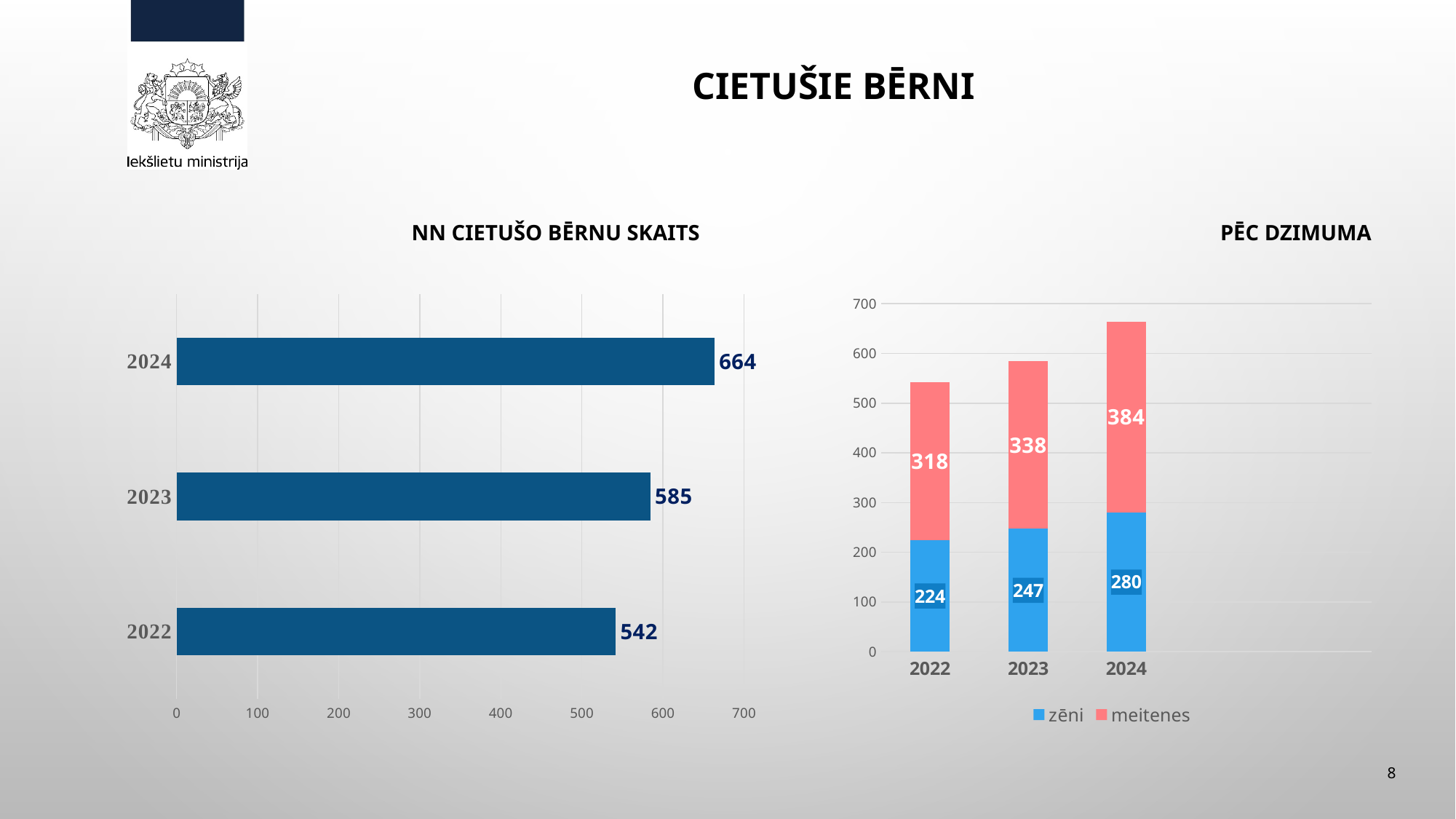
In the 'PĒC DZIMUMA' chart, what is the value for meitenes in 2023? 338 In the 'PĒC DZIMUMA' chart, what is the total of the stacked bar for 2022? 542 In the 'NN CIETUŠO BĒRNU SKAITS' chart, what is the value for 2022? 542 In the 'PĒC DZIMUMA' chart, what is the difference between meitenes and zēni in 2023? 91 In the 'PĒC DZIMUMA' chart, which is larger in 2024, zēni or meitenes? meitenes How many series does the legend of the 'PĒC DZIMUMA' chart list? 2 In the 'NN CIETUŠO BĒRNU SKAITS' chart, which year has the lowest value? 2022 What kind of chart is the 'NN CIETUŠO BĒRNU SKAITS' chart? bar chart In the 'NN CIETUŠO BĒRNU SKAITS' chart, do the values rise or fall from 2022 to 2024? rise In the 'NN CIETUŠO BĒRNU SKAITS' chart, what is the value for 2024? 664 In the 'PĒC DZIMUMA' chart, what is the value for zēni in 2024? 280 In the 'NN CIETUŠO BĒRNU SKAITS' chart, what is the difference between the 2024 and 2023 values? 79